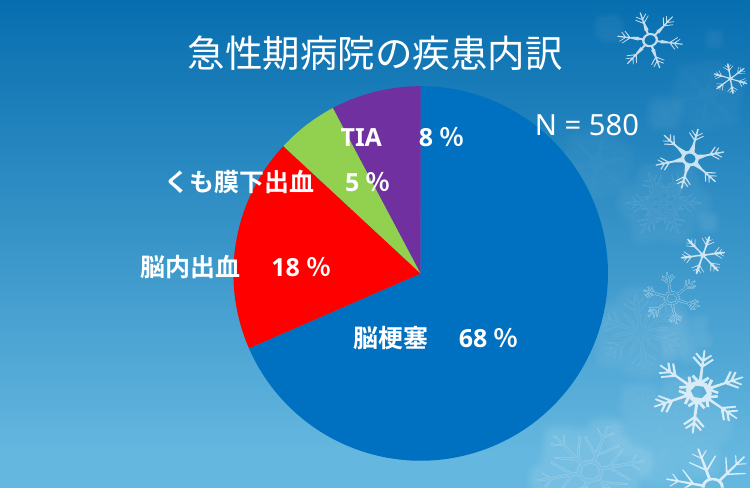
How many categories are shown in the pie chart? 4 Which category has the largest share of the pie? 脳梗塞 What is the difference in percentage points between 脳梗塞 and 脳内出血? 50 % What is the total N shown on the slide? N = 580 What percentage of the pie does 脳内出血 account for? 18 % What percentage of the pie does TIA account for? 8 % What percentage of the pie does 脳梗塞 account for? 68 % Which has a larger share, TIA or くも膜下出血? TIA Which category has the smallest share of the pie? くも膜下出血 What is the title of the chart? 急性期病院の疾患内訳 What type of chart is shown on the slide? pie chart